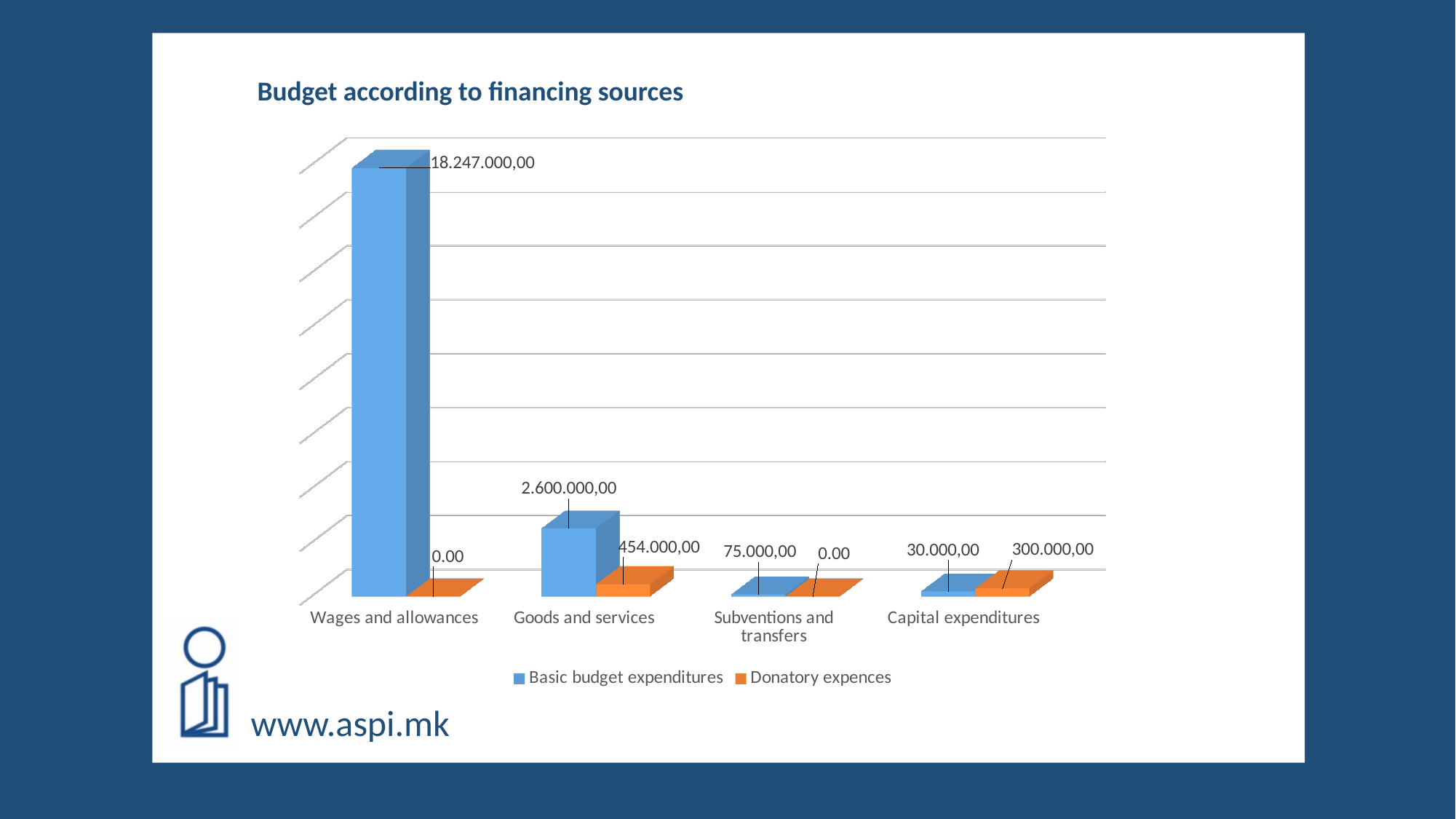
What is the value of Basic budget expenditures for Subventions and transfers? 75.000,00 What is the difference between Donatory expences and Basic budget expenditures for Capital expenditures? 270.000,00 How many series does the legend list? 2 What is the value of Donatory expences for Capital expenditures? 300.000,00 What is the difference between Basic budget expenditures and Donatory expences for Goods and services? 2.146.000,00 How many categories are shown on the x axis? 4 What is the value of Donatory expences for Goods and services? 454.000,00 What type of chart is shown on the slide? Bar chart Which category has the lowest Basic budget expenditures? Capital expenditures What is the value of Basic budget expenditures for Wages and allowances? 18.247.000,00 For Capital expenditures, which is larger: Basic budget expenditures or Donatory expences? Donatory expences Which category has the highest Basic budget expenditures? Wages and allowances